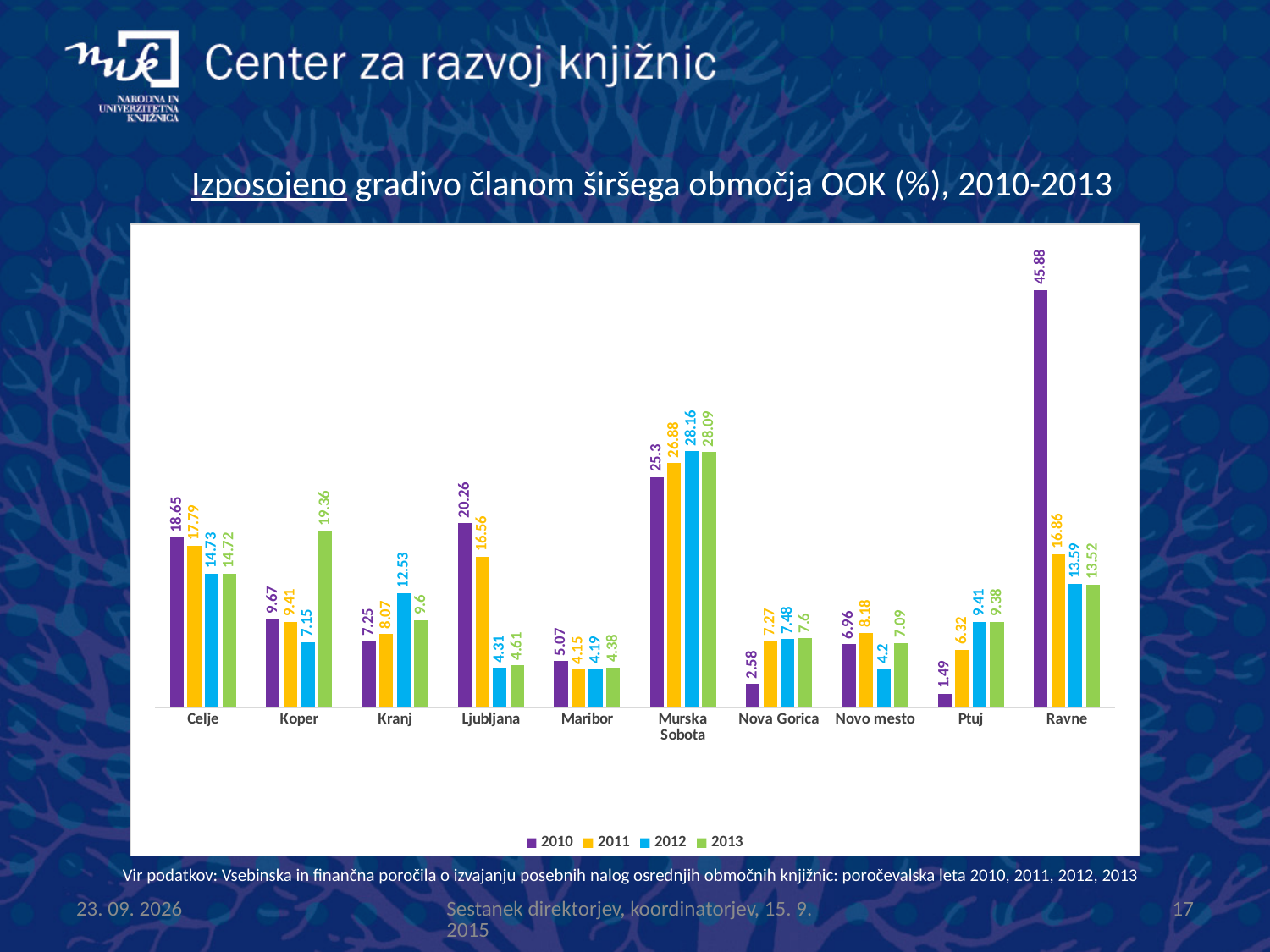
Which category has the highest value in 2010? Ravne What is the value for Ptuj in 2010? 1.49 How many categories are shown on the x axis? 10 What is the difference between the 2013 and 2010 values for Koper? 9.69 What is the difference between the 2010 and 2011 values for Ravne? 29.02 Which is larger for Ljubljana: the 2010 value or the 2011 value? 2010 How many series does the legend list? 4 Which category has the lowest value in 2013? Maribor What is the value for Murska Sobota in 2012? 28.16 What is the value for Koper in 2013? 19.36 What kind of chart is shown on the slide? Bar chart What is the value for Ravne in 2010? 45.88